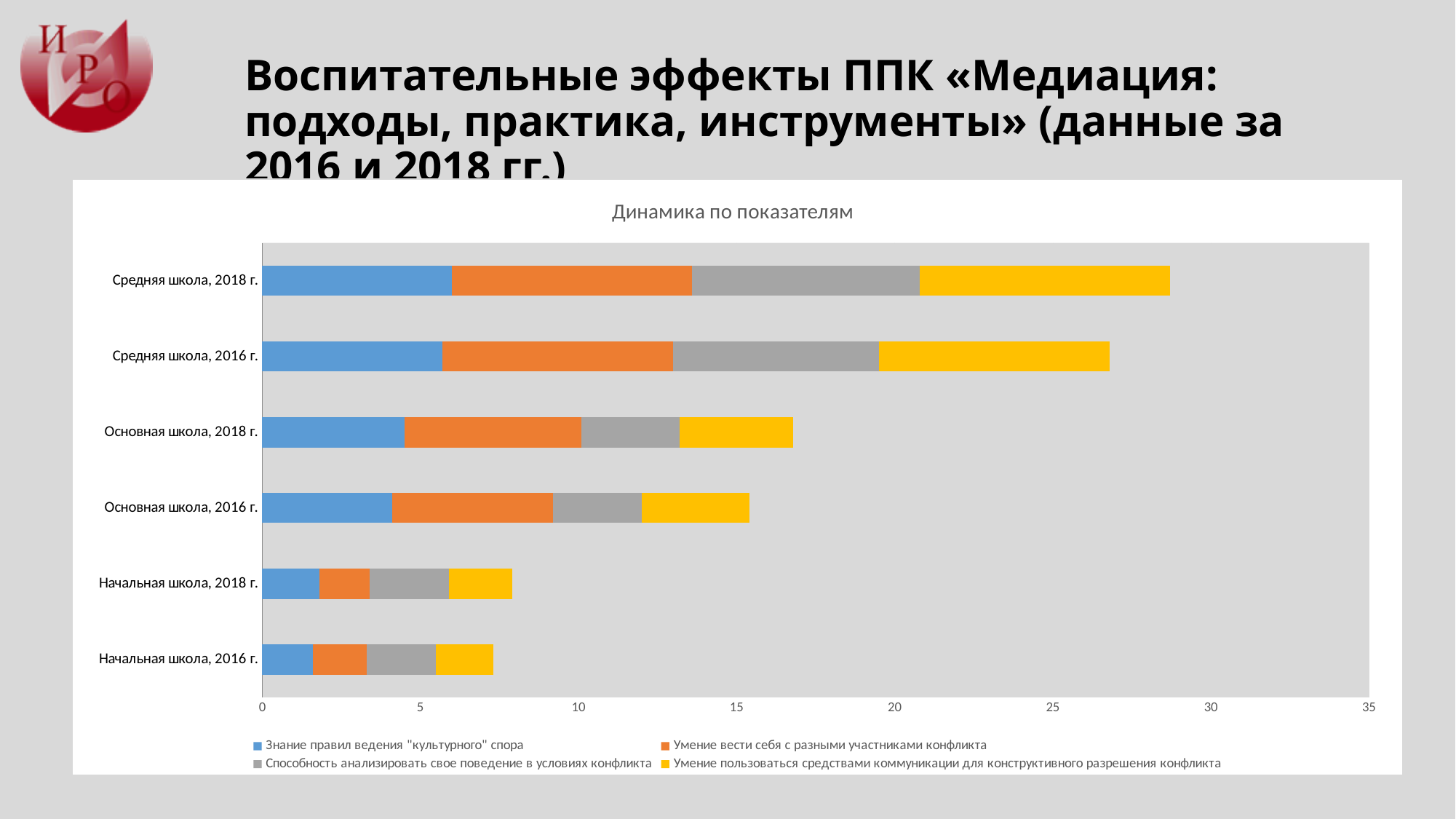
Is the total bar for Начальная школа, 2018 г. greater or less than 10? less Which series is shown in yellow in the legend? Умение пользоваться средствами коммуникации для конструктивного разрешения конфликта Which has the longer total bar: Средняя школа, 2016 г. or Основная школа, 2018 г.? Средняя школа, 2016 г. Is the total bar for Средняя школа, 2018 г. greater or less than 25? greater What is the title of the chart? Динамика по показателям Which category has the longest total bar? Средняя школа, 2018 г. Is the total bar for Средняя школа, 2016 г. greater or less than 30? less How many series does the legend list? 4 What kind of chart is shown on the slide? Stacked bar chart Which has the longer total bar: Основная школа, 2018 г. or Основная школа, 2016 г.? Основная школа, 2018 г. How many categories (bars) are shown on the chart? 6